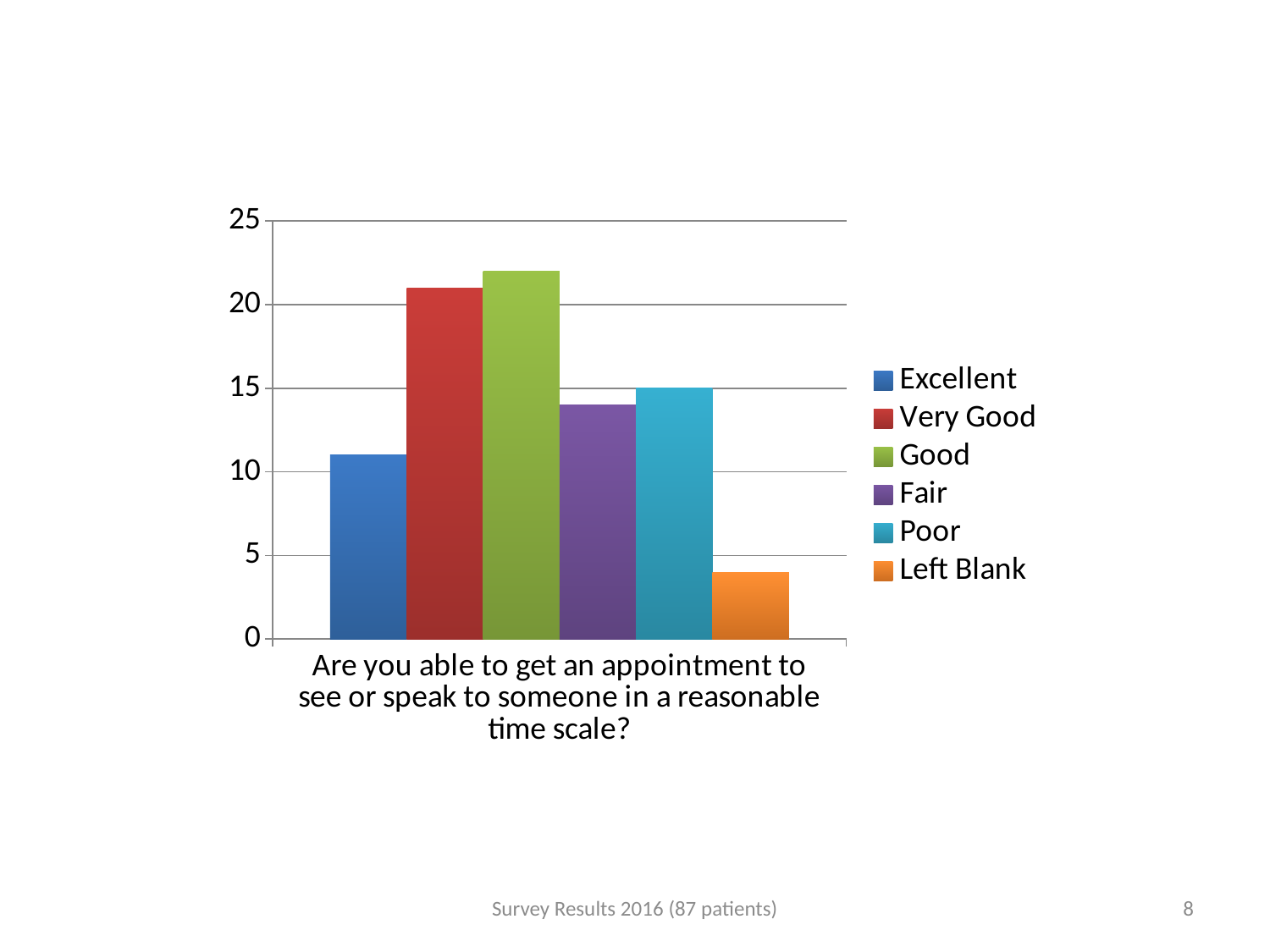
Is the value for Left Blank greater or less than 5? less Is the value for Excellent greater or less than 10? greater Which is larger, the value for Very Good or the value for Poor? Very Good What colour represents Good in the legend? green Which response category has the lowest bar? Left Blank What kind of chart is shown on the slide? bar chart Is the value for Fair greater or less than 15? less Which is larger, the value for Excellent or the value for Fair? Fair What question is shown as the category label on the x axis? Are you able to get an appointment to see or speak to someone in a reasonable time scale? How many series does the legend list? 6